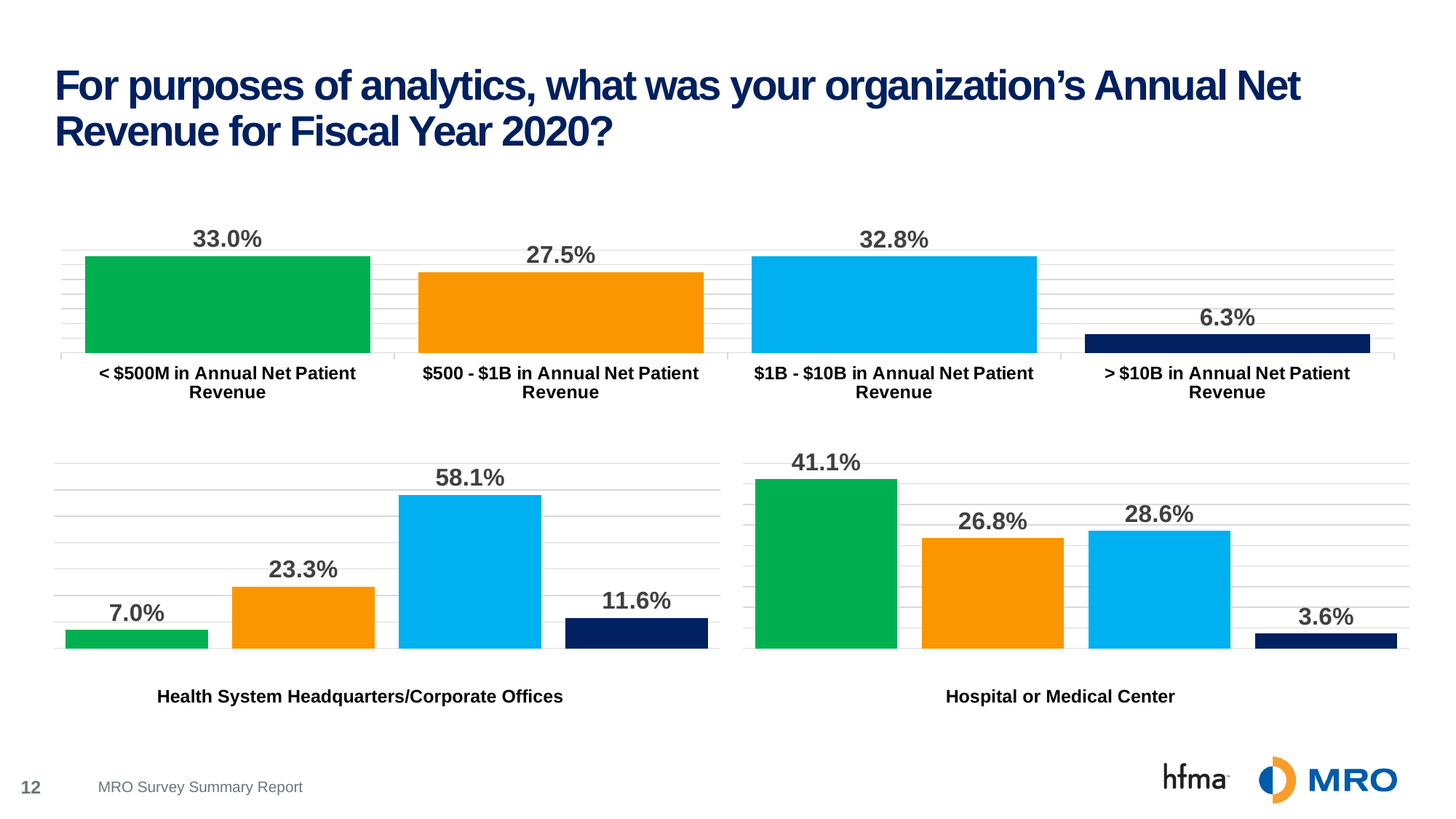
In the Hospital or Medical Center chart, what is the difference between the green bar and the dark blue bar? 37.5% In the top chart, what percentage of respondents reported < $500M in Annual Net Patient Revenue? 33.0% How many revenue categories are shown in the top chart? 4 In the Hospital or Medical Center chart, what is the value of the green bar? 41.1% In the Hospital or Medical Center chart, which is larger: the orange bar or the light blue bar? the light blue bar (28.6%) In the top chart, what is the value for > $10B in Annual Net Patient Revenue? 6.3% In the Health System Headquarters/Corporate Offices chart, what is the value of the tallest (light blue) bar? 58.1% In the top chart, which revenue category has the lowest percentage? > $10B in Annual Net Patient Revenue In the top chart, which revenue category has the highest percentage? < $500M in Annual Net Patient Revenue In the Health System Headquarters/Corporate Offices chart, what is the value of the green bar? 7.0% In the top chart, what is the difference between the $500 - $1B category and the > $10B category? 21.2% What type of chart is used on this slide? Bar chart